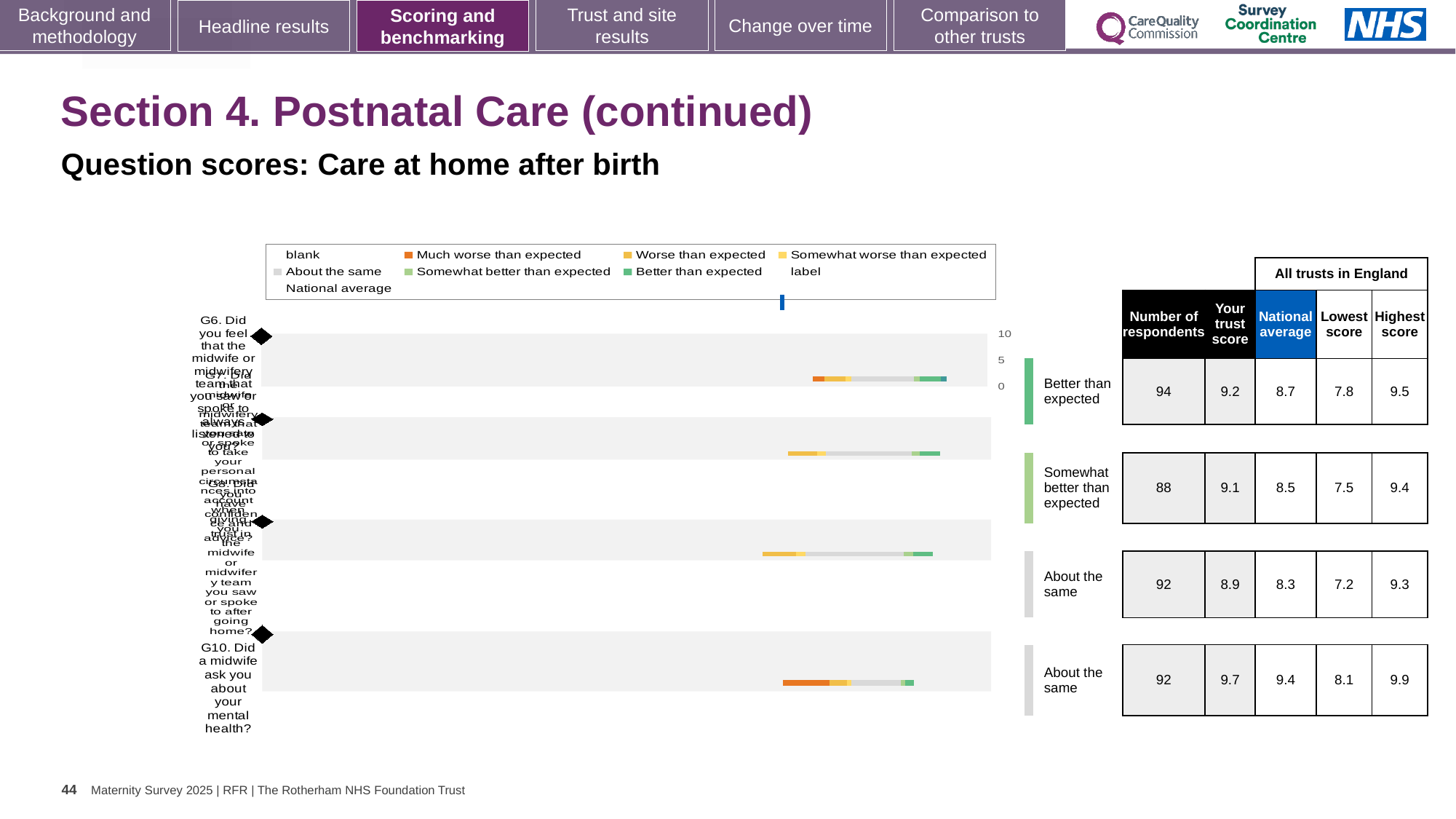
How many question bars are plotted in the chart? 4 For the top row (G6), which is larger: 'Your trust score' or the national average? Your trust score What kind of chart is shown on the slide? bar chart In the table beside the chart, what is the national average for the bottom row (G10)? 9.4 Which row in the table has the highest 'Your trust score'? G10 (bottom row), 9.7 In the table beside the chart, what is the 'Your trust score' for the top row (G6, labelled 'Better than expected')? 9.2 What benchmark category label is shown for the bottom row (G10)? About the same In the table beside the chart, what is the number of respondents for the bottom row (G10, mental health question)? 92 For the bottom row (G10), what is the difference between 'Your trust score' and the national average? 0.3 In the table, what is the highest score for the row labelled 'Somewhat better than expected'? 9.4 What is the subtitle describing the chart's content? Question scores: Care at home after birth Which row in the table has the smallest 'Lowest score' value? Third row (About the same), 7.2